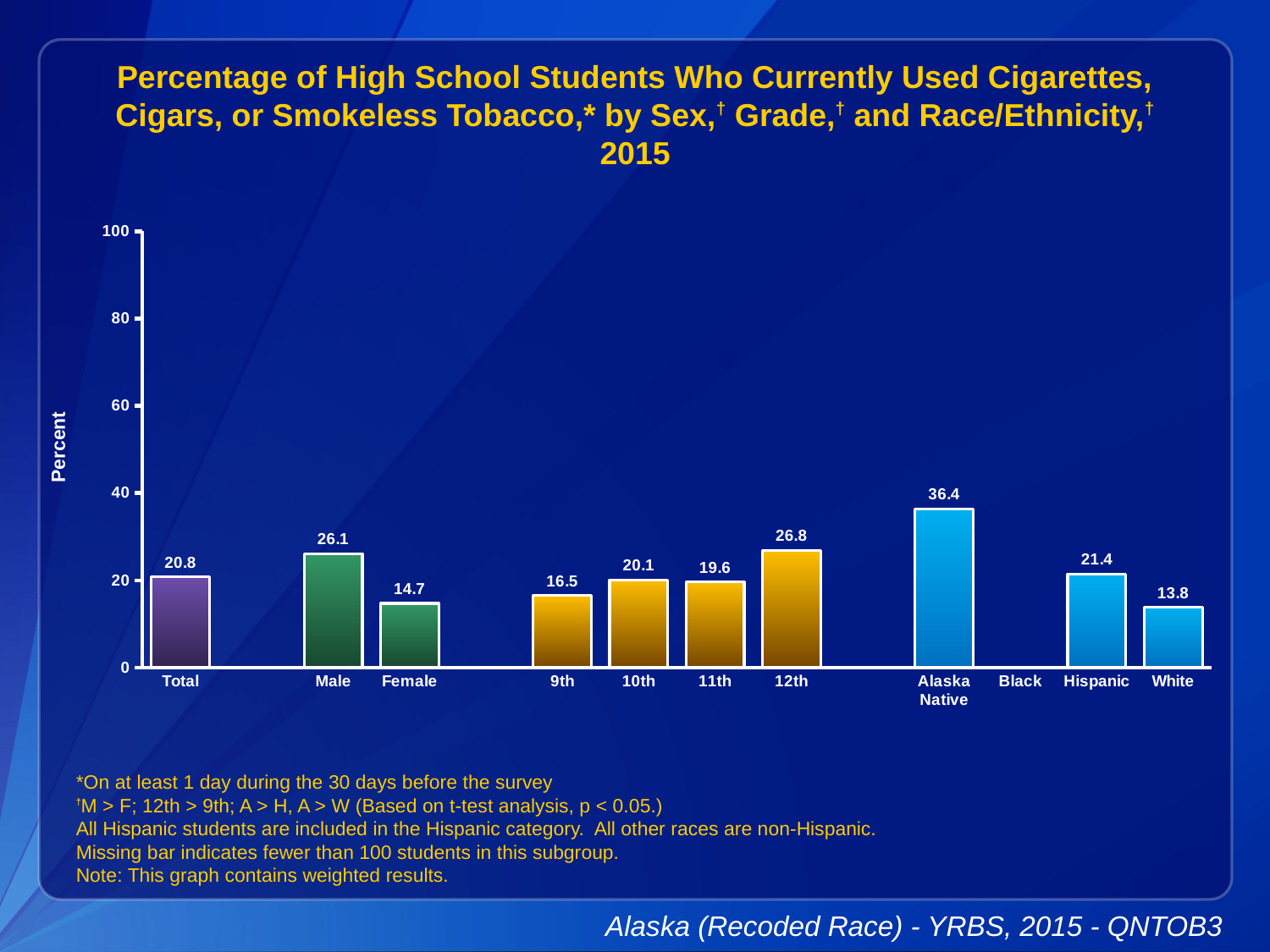
What is the value for Total? 20.8 Which category with a plotted bar has the lowest value? White What is the value for Male? 26.1 Which category has no bar shown? Black Which category has the highest value? Alaska Native What is the value for 12th grade? 26.8 What is the value for Alaska Native? 36.4 Which is larger, the value for 9th grade or 12th grade? 12th What kind of chart is shown? bar chart Is the value for Alaska Native greater or less than 40? less What is the difference between the Male and Female values? 11.4 How many categories have a plotted bar? 11